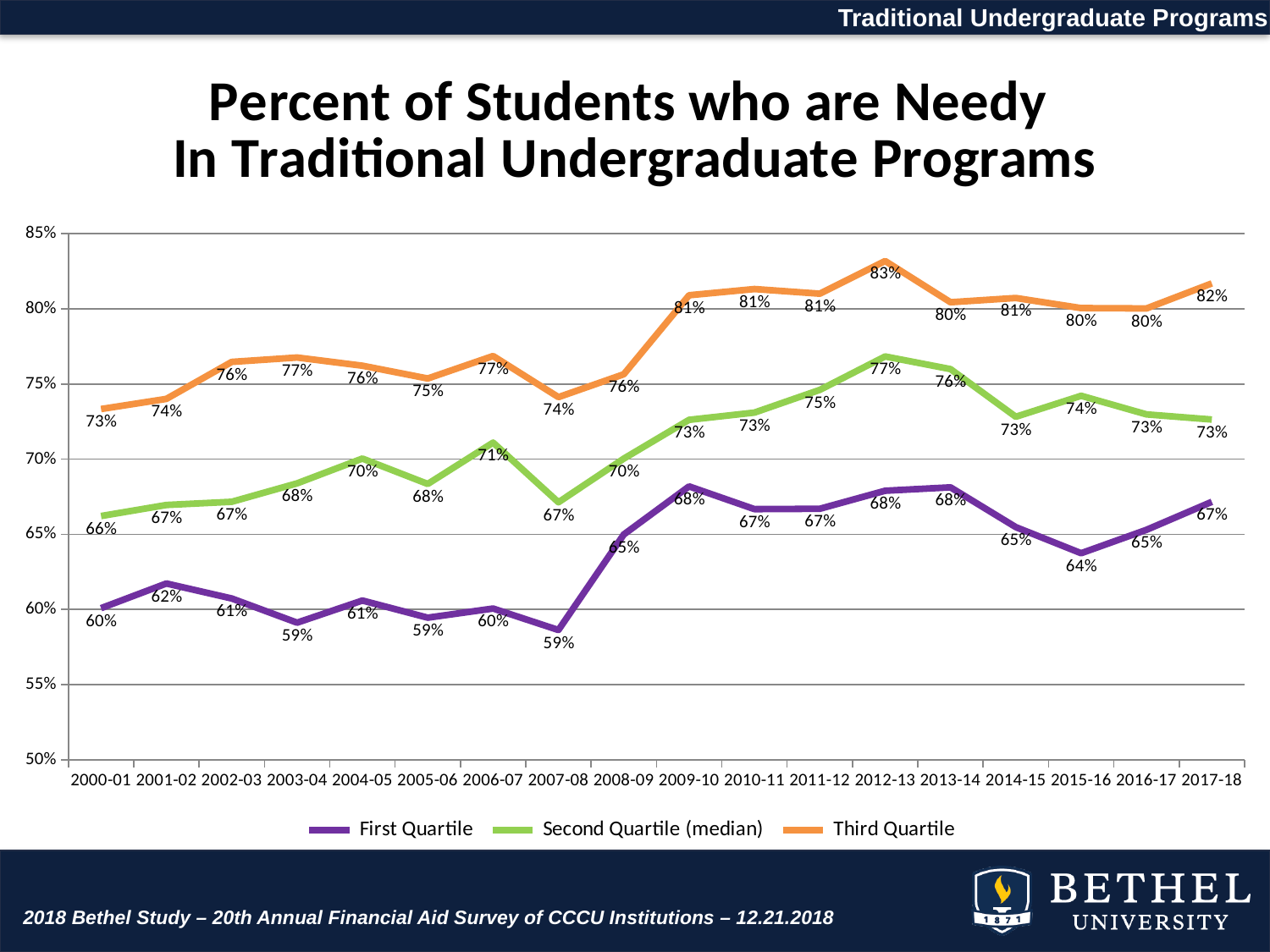
Does the Third Quartile generally rise or fall from 2000-01 to 2017-18? rise In which year does the Second Quartile (median) reach its highest value? 2012-13 What is the Third Quartile value for 2012-13? 83% What type of chart is shown on the slide? line chart How many academic years are plotted on the x axis? 18 What is the Second Quartile (median) value for 2017-18? 73% How many series does the legend list? 3 What is the First Quartile value for 2000-01? 60% Which is larger, the First Quartile value in 2009-10 or in 2015-16? 2009-10 In which year does the Third Quartile reach its highest value? 2012-13 Which series is drawn in orange? Third Quartile What is the difference between the Third Quartile and First Quartile values in 2017-18? 15%